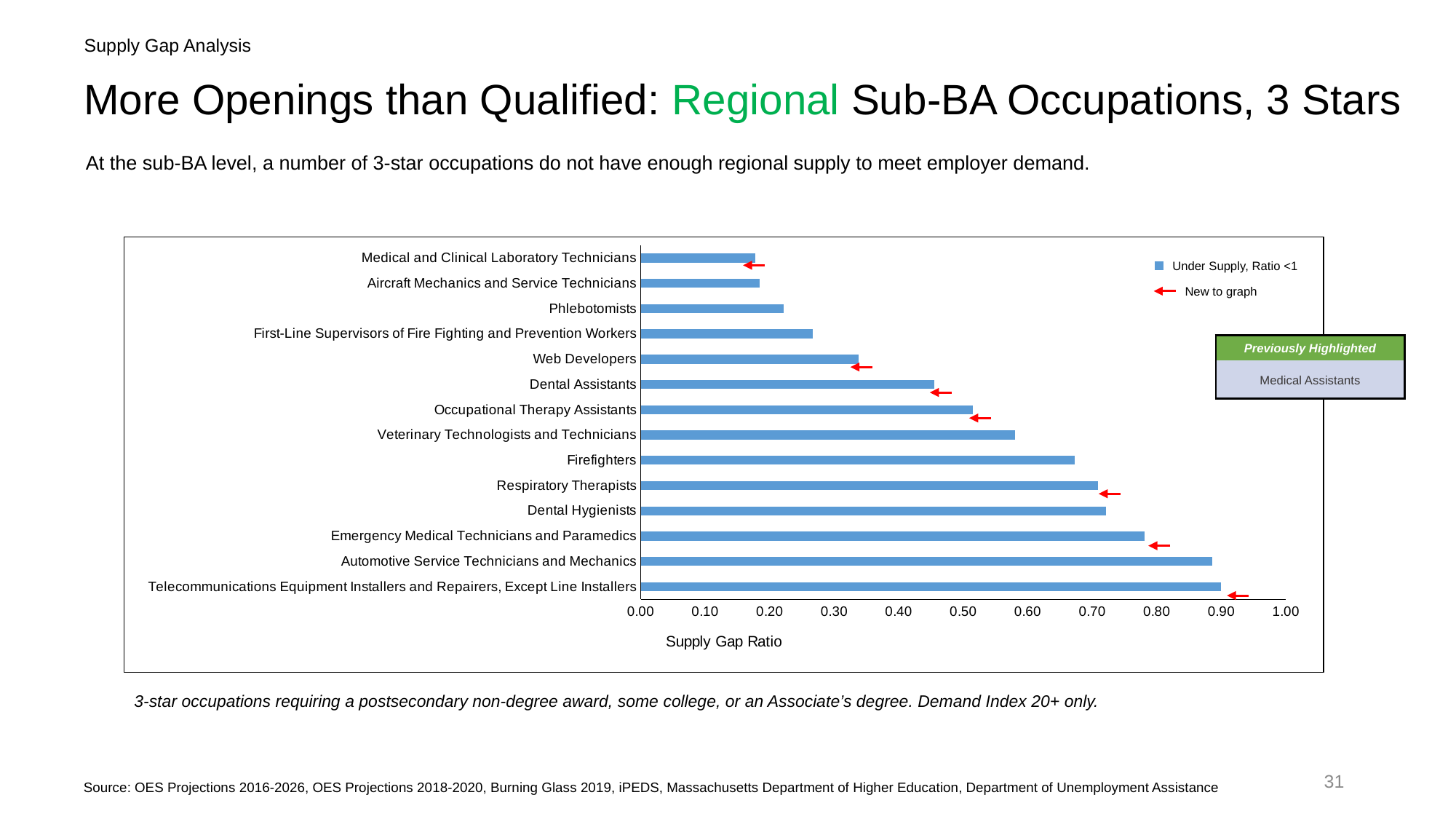
Is the Supply Gap Ratio for Web Developers greater or less than 0.30? greater Which has a higher Supply Gap Ratio, Web Developers or Phlebotomists? Web Developers Is the Supply Gap Ratio for Emergency Medical Technicians and Paramedics greater or less than 0.80? less Is the Supply Gap Ratio for First-Line Supervisors of Fire Fighting and Prevention Workers greater or less than 0.30? less How many occupations are marked with a red arrow as new to the graph? 7 What is the title of the horizontal axis of the chart? Supply Gap Ratio Which has a higher Supply Gap Ratio, Firefighters or Dental Assistants? Firefighters How many occupations are plotted in the chart? 14 What kind of chart is shown on the slide? Bar chart